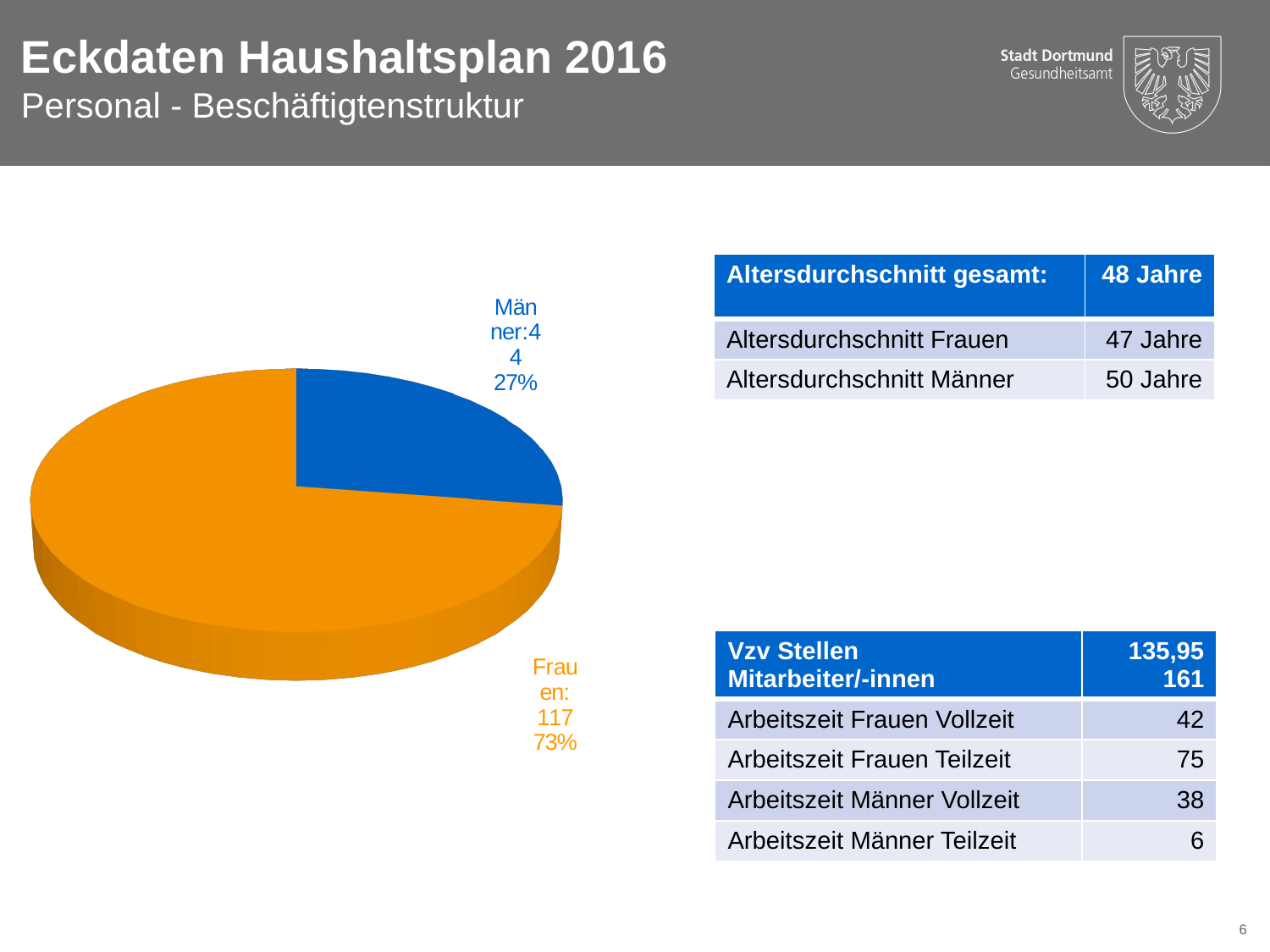
What is the value shown for Männer in the pie chart? 44 What is the total of the two values shown in the pie chart? 161 Which slice of the pie chart is the smallest? Männer Which is larger in the pie chart, Frauen or Männer? Frauen How many slices does the pie chart have? 2 What is the value shown for Frauen in the pie chart? 117 What share of the pie does the Männer slice represent? 27% What colour is the Männer slice in the pie chart? blue What kind of chart is shown on the slide? pie chart Which slice of the pie chart is the largest? Frauen What share of the pie does the Frauen slice represent? 73% What is the difference between the Frauen value and the Männer value in the pie chart? 73